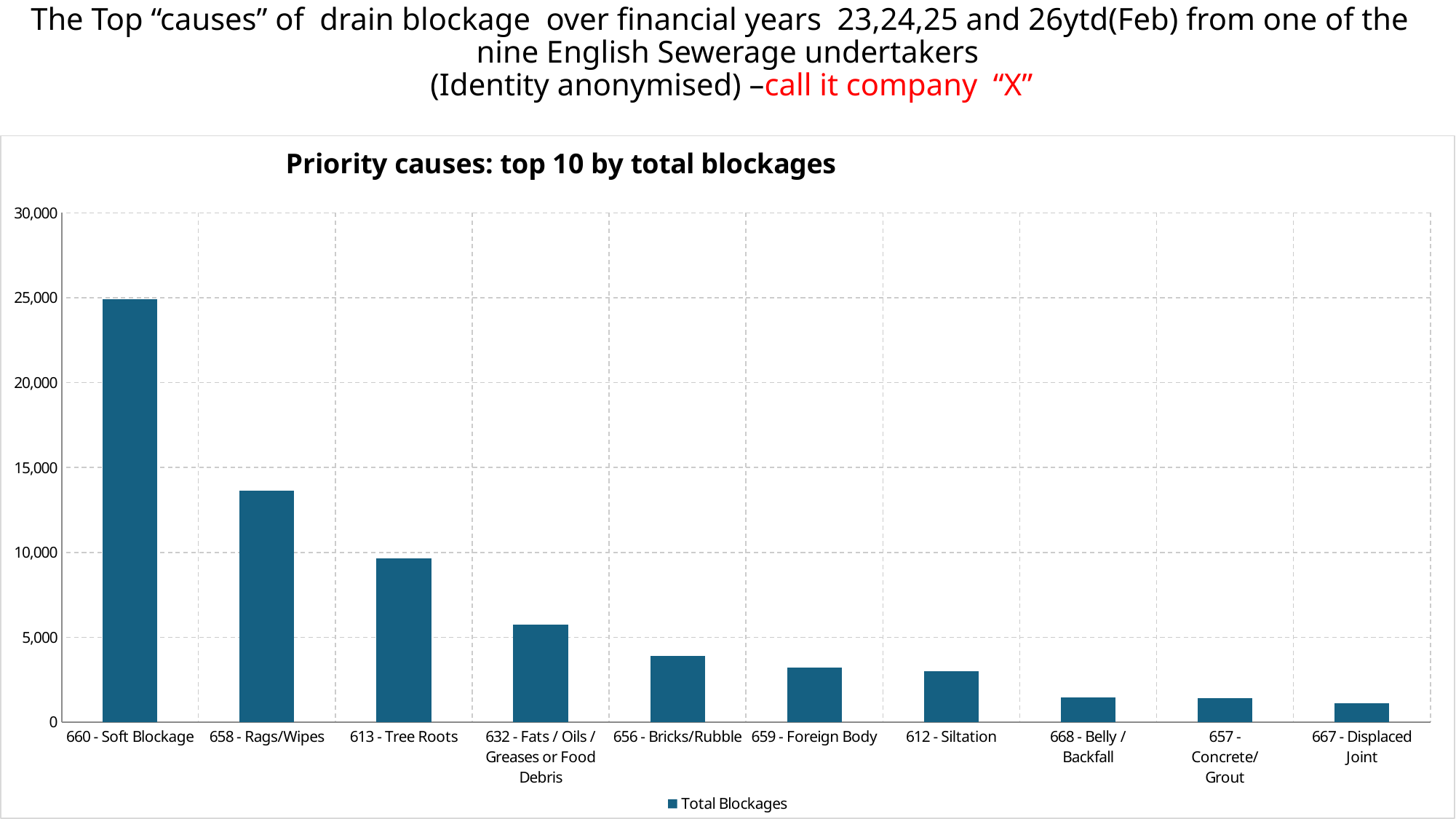
Is the value for 632 - Fats / Oils / Greases or Food Debris greater or less than 5,000? greater Which cause has the highest total blockages? 660 - Soft Blockage What is the title of the chart? Priority causes: top 10 by total blockages How many series does the legend list? 1 Is the value for 658 - Rags/Wipes greater or less than 15,000? less Which is larger, the value for 658 - Rags/Wipes or the value for 613 - Tree Roots? 658 - Rags/Wipes Is the value for 613 - Tree Roots greater or less than 10,000? less What type of chart is shown on the slide? bar chart Do the values rise or fall moving from left to right along the x axis? fall How many categories (causes) are plotted on the chart? 10